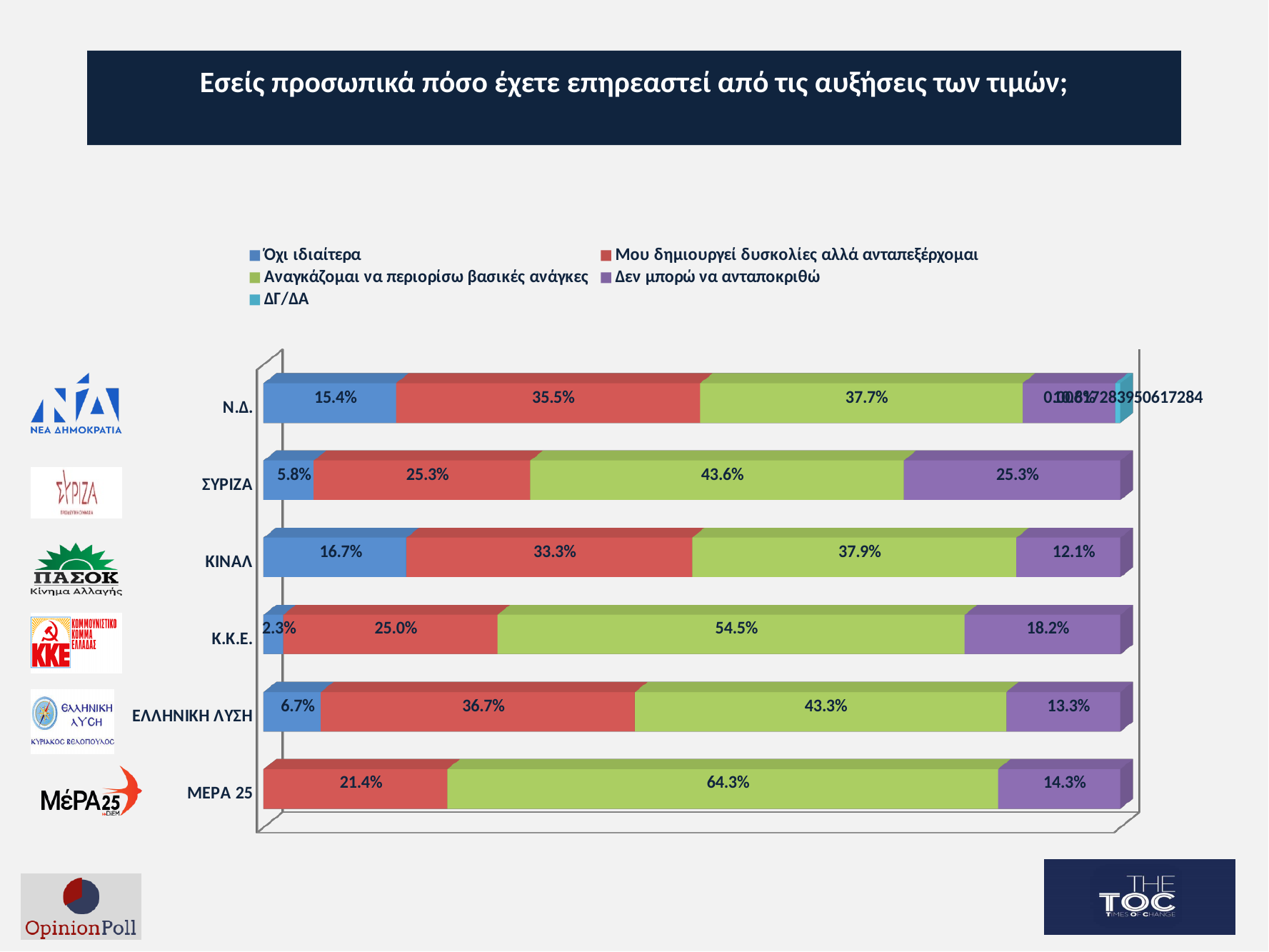
What is the value for 'Μου δημιουργεί δυσκολίες αλλά ανταπεξέρχομαι' for ΕΛΛΗΝΙΚΗ ΛΥΣΗ? 36.7% Which is larger: the 'Μου δημιουργεί δυσκολίες αλλά ανταπεξέρχομαι' value for Ν.Δ. or for ΣΥΡΙΖΑ? Ν.Δ. Which party has the highest value for 'Αναγκάζομαι να περιορίσω βασικές ανάγκες'? ΜΕΡΑ 25 What is the value for 'Αναγκάζομαι να περιορίσω βασικές ανάγκες' for ΜΕΡΑ 25? 64.3% Which series is shown in green in the legend? Αναγκάζομαι να περιορίσω βασικές ανάγκες What kind of chart is shown on the slide? Stacked bar chart What is the value for 'Δεν μπορώ να ανταποκριθώ' for ΣΥΡΙΖΑ? 25.3% How many series does the legend list? 5 How many parties (categories) are shown on the chart? 6 What is the value for 'Όχι ιδιαίτερα' for ΚΙΝΑΛ? 16.7% What is the difference between the 'Δεν μπορώ να ανταποκριθώ' values for ΣΥΡΙΖΑ and ΚΙΝΑΛ? 13.2% Which party has the lowest value for 'Όχι ιδιαίτερα' among those with a printed value? Κ.Κ.Ε.